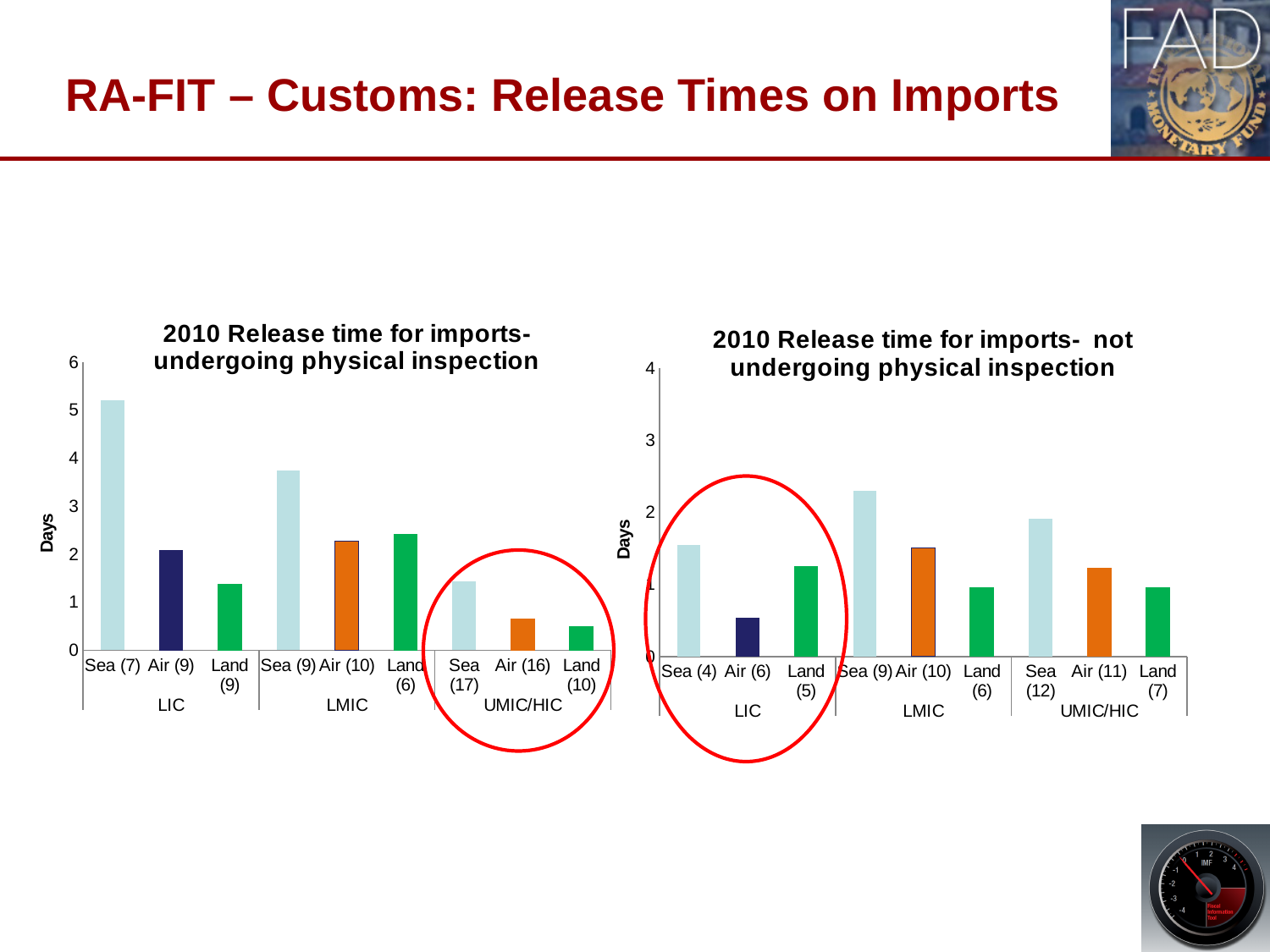
In the left chart (undergoing physical inspection), which bar is the lowest? Land (10) in UMIC/HIC In the left chart (undergoing physical inspection), which is larger for LIC: Air (9) or Land (9)? Air (9) What kind of chart is the left chart, '2010 Release time for imports- undergoing physical inspection'? Bar chart In the right chart (not undergoing physical inspection), is the value for Sea (9) in LMIC greater or less than 2? greater What is the label on the vertical axis of the right chart (not undergoing physical inspection)? Days In the right chart (not undergoing physical inspection), is the value for Air (6) in LIC greater or less than 1? less In the left chart (undergoing physical inspection), is the value for Sea (9) in LMIC greater or less than 3? greater In the right chart (not undergoing physical inspection), which bar is the lowest? Air (6) in LIC In the left chart (undergoing physical inspection), which bar is the highest? Sea (7) in LIC In the right chart (not undergoing physical inspection), which bar is the highest? Sea (9) in LMIC How many bars are plotted in the left chart (undergoing physical inspection)? 9